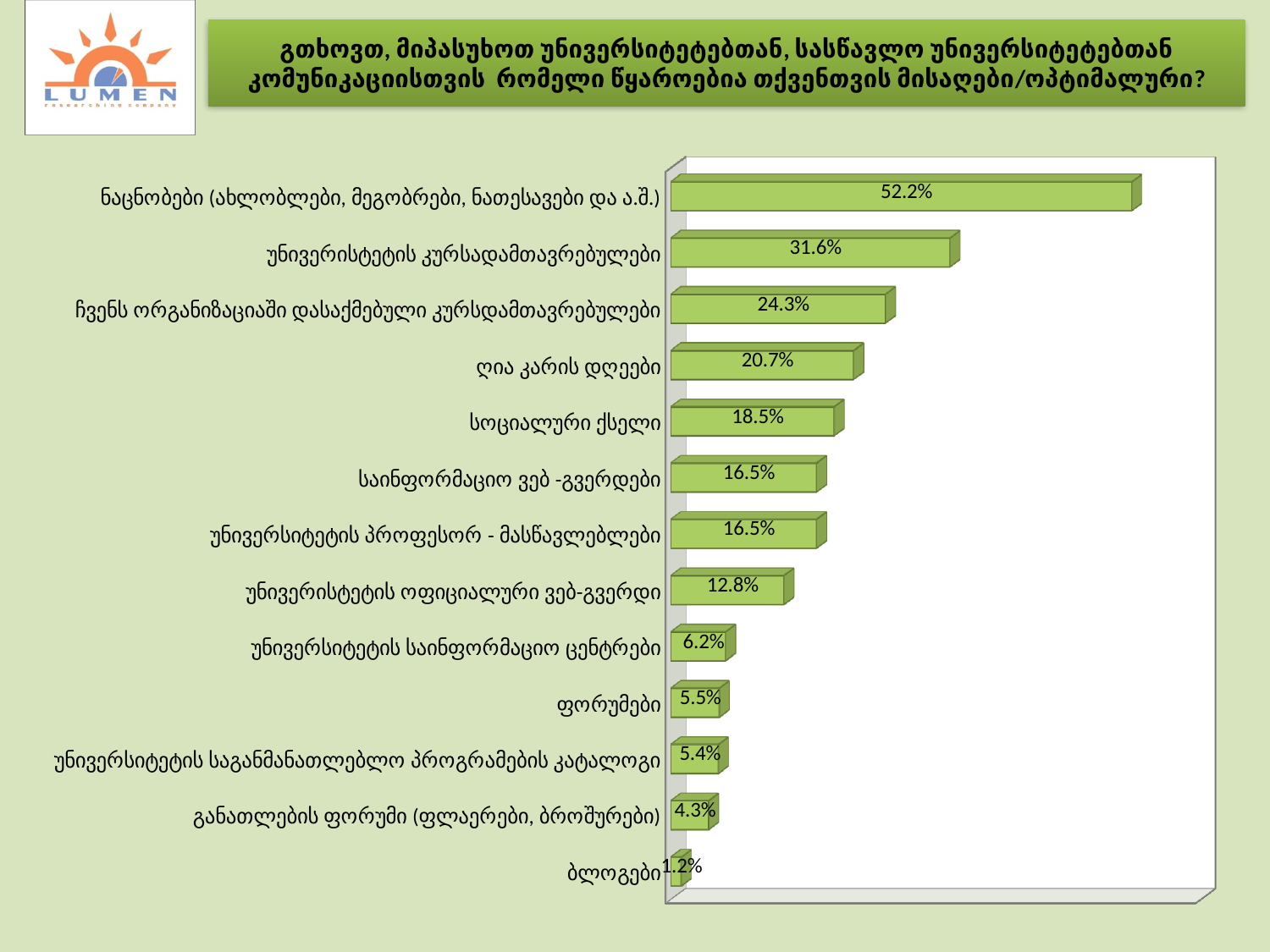
What is the value for ფორუმები? 5.5% Which is larger: the value for ჩვენს ორგანიზაციაში დასაქმებული კურსდამთავრებულები or the value for სოციალური ქსელი? ჩვენს ორგანიზაციაში დასაქმებული კურსდამთავრებულები How many categories are shown in the chart? 13 What kind of chart is shown on the slide? bar chart What is the value for ნაცნობები (ახლობლები, მეგობრები, ნათესავები და ა.შ.)? 52.2% What colour are the bars in the chart? green What is the value for უნივერსიტეტის ოფიციალური ვებ-გვერდი? 12.8% Which category has the lowest value? ბლოგები What is the difference between the values for უნივერისტეტის კურსადამთავრებულები and ღია კარის დღეები? 10.9% What is the value for სოციალური ქსელი? 18.5% Which category has the highest value? ნაცნობები (ახლობლები, მეგობრები, ნათესავები და ა.შ.) What is the difference between the values for უნივერსიტეტის საინფორმაციო ცენტრები and განათლების ფორუმი (ფლაერები, ბროშურები)? 1.9%